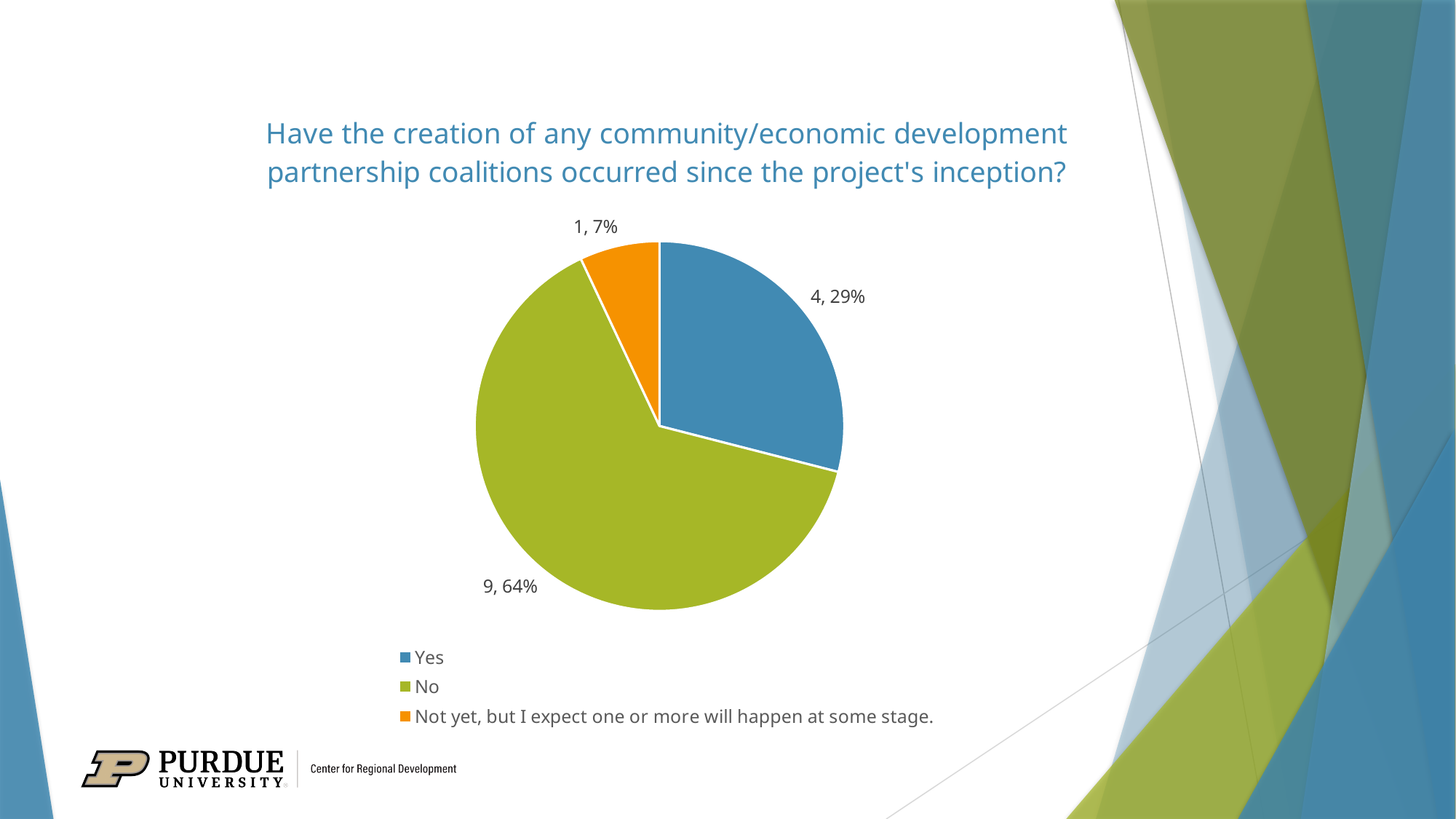
How many respondents answered "Not yet, but I expect one or more will happen at some stage."? 1 What colour is the "Yes" slice? blue How many respondents answered "Yes"? 4 How many more respondents answered "No" than "Yes"? 5 What share of the pie does the "No" slice represent? 64% Which response category has the smallest slice? Not yet, but I expect one or more will happen at some stage. What share of the pie does the "Yes" slice represent? 29% What kind of chart is shown on the slide? pie chart Which response category has the largest slice? No How many respondents answered "No"? 9 How many categories does the pie chart have? 3 What share of the pie does the "Not yet, but I expect one or more will happen at some stage." slice represent? 7%